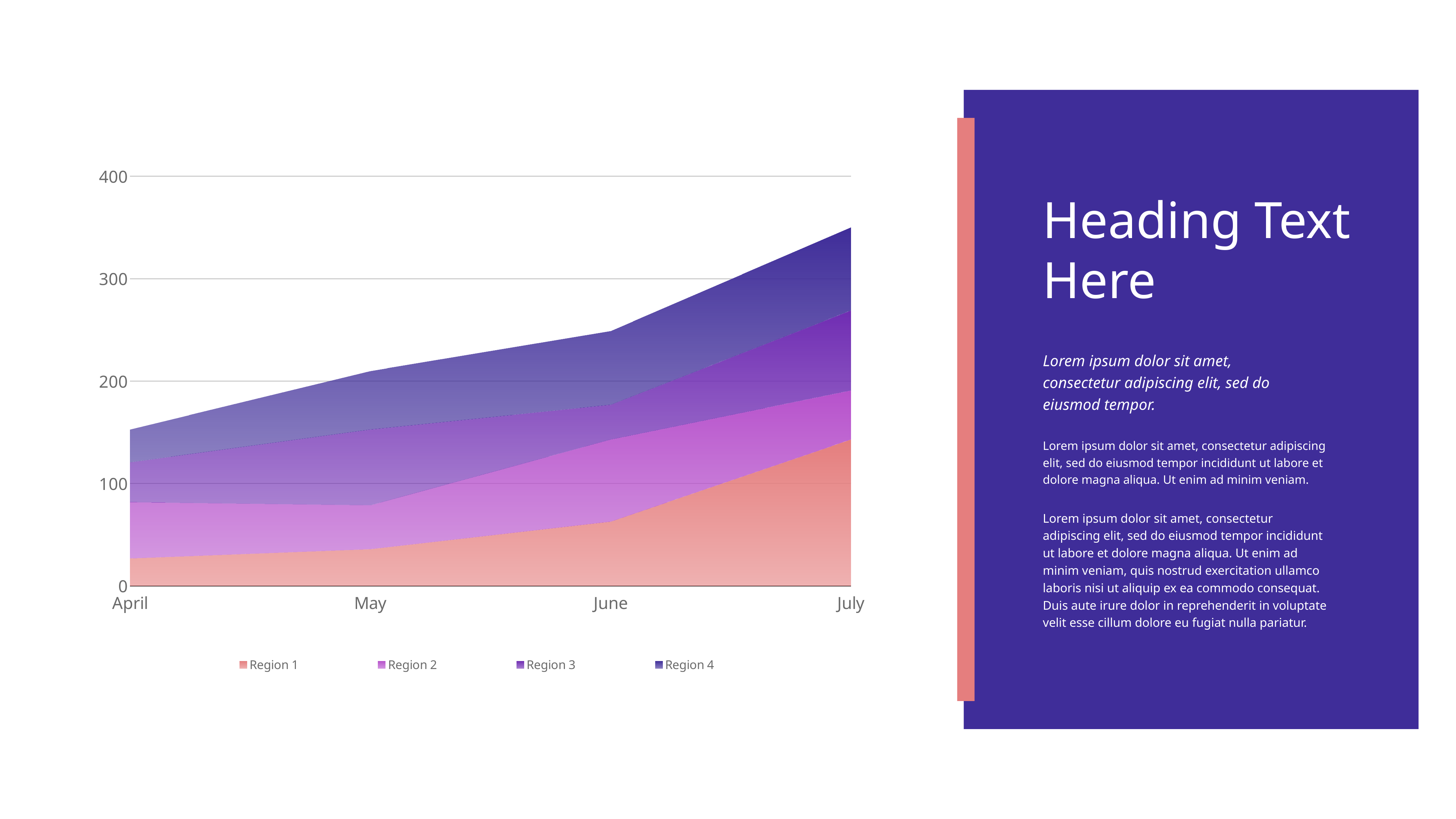
Which month has the lowest stacked total? April Is the value for Region 1 in April greater or less than 100? less Is the stacked total for April greater or less than 200? less Which month has the highest stacked total? July How many months are shown on the x axis? 4 Which is larger, the stacked total for June or the stacked total for April? June How many series does the legend list? 4 Is the value for Region 1 in July greater or less than 100? greater Do the stacked totals rise or fall from April to July? Rise Which series is listed first in the legend? Region 1 What kind of chart is shown on the slide? Stacked area chart